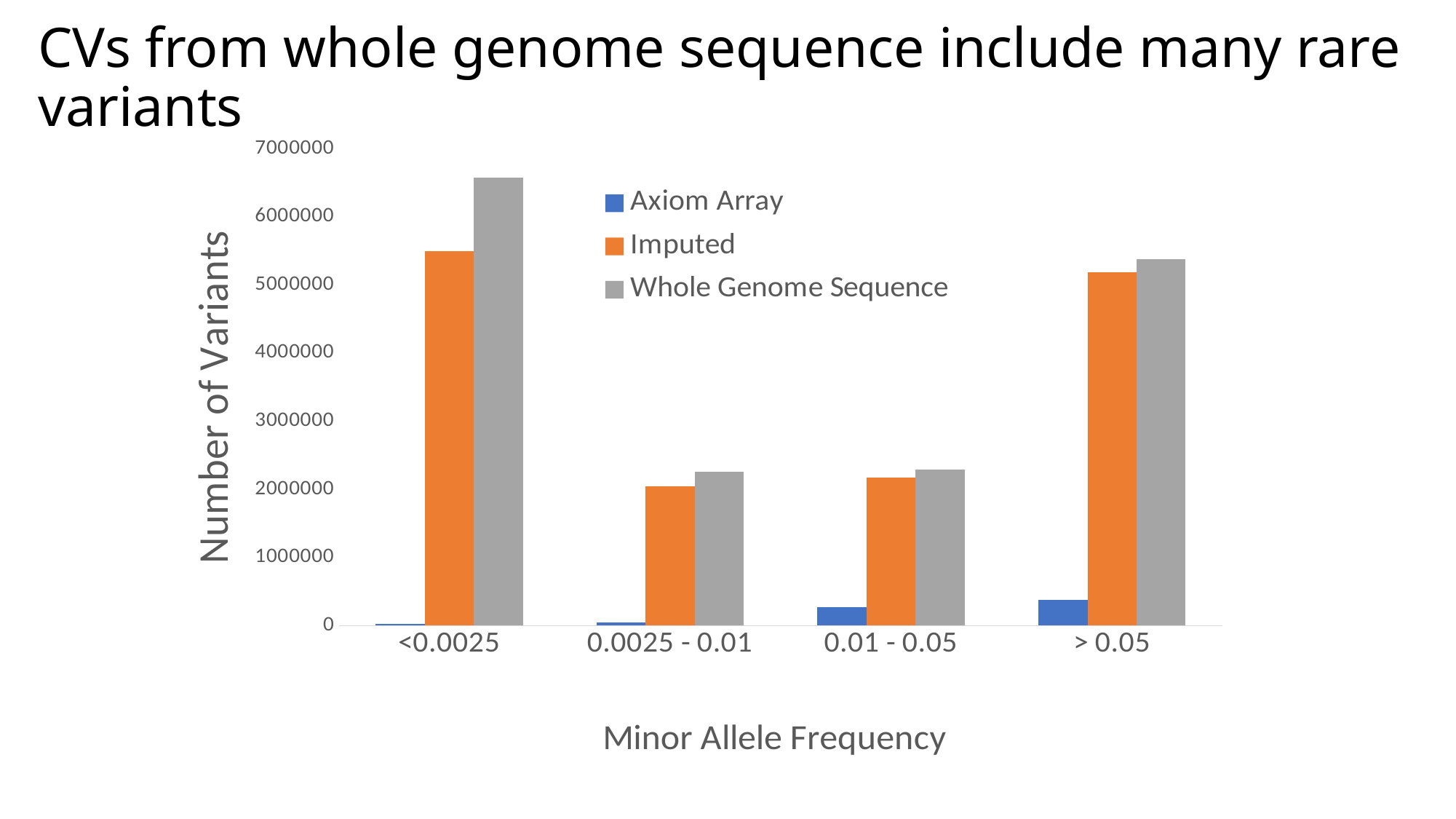
Is the Whole Genome Sequence value for <0.0025 greater or less than 6000000? greater Which minor allele frequency category has the highest Whole Genome Sequence value? <0.0025 Is the Imputed value for <0.0025 greater or less than 5000000? greater Which series has the lowest value in the <0.0025 category? Axiom Array What kind of chart is shown on the slide? bar chart How many series does the legend list? 3 How many minor allele frequency categories are shown on the x axis? 4 Is the Whole Genome Sequence value for 0.0025 - 0.01 greater or less than 2000000? greater What is the label of the y axis? Number of Variants Which series has the highest value in the > 0.05 category? Whole Genome Sequence Which is larger: the Imputed value for <0.0025 or the Imputed value for > 0.05? <0.0025